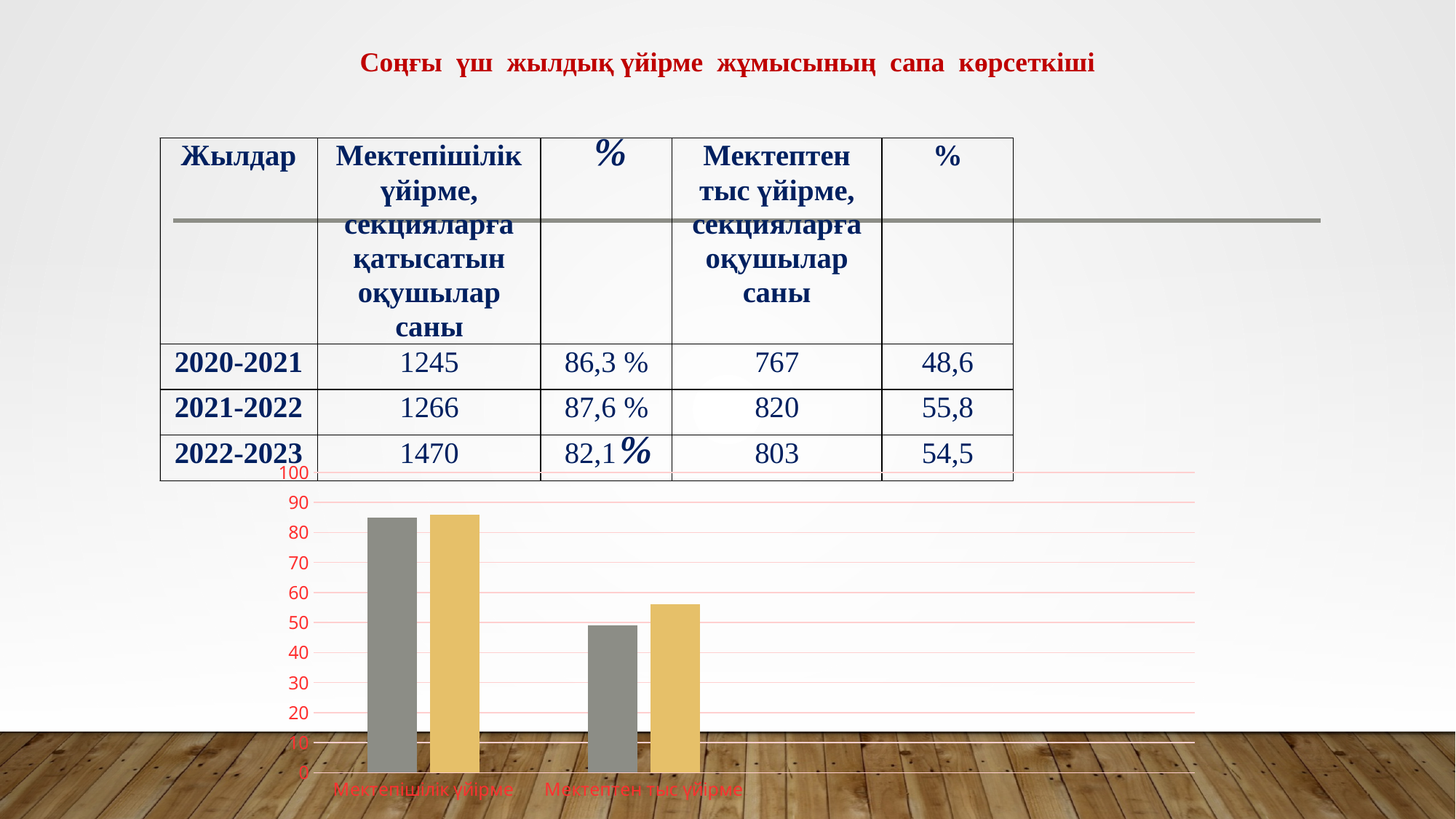
In the bar chart, is the value of the gray bar for Мектептен тыс үйірме greater or less than 60? less In the bar chart, which category has the taller bars, Мектепішілік үйірме or Мектептен тыс үйірме? Мектепішілік үйірме What is the highest value shown on the y axis of the bar chart? 100 In the bar chart, for Мектептен тыс үйірме, which bar is taller, the gray one or the yellow one? The yellow one How many bars are plotted in the bar chart in total? 4 What two colours are used for the bars in the bar chart? Gray and yellow In the bar chart, is the value of the yellow bar for Мектепішілік үйірме greater or less than 90? less In the bar chart, is the value of the gray bar for Мектепішілік үйірме greater or less than 80? greater How many categories are shown on the x axis of the bar chart? 2 What kind of chart is shown at the bottom of the slide? Bar chart